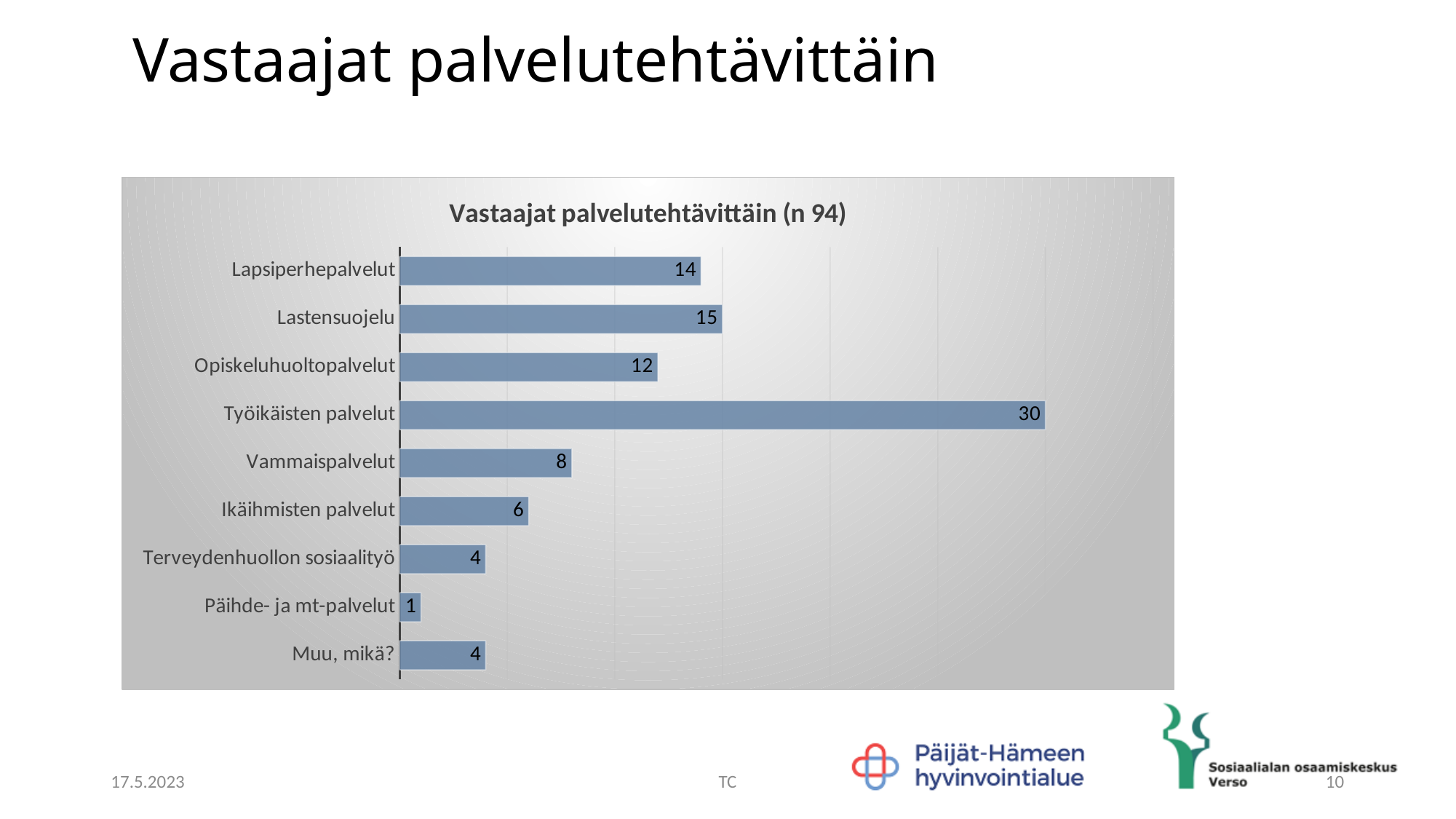
Which is larger, the value for Lapsiperhepalvelut or the value for Opiskeluhuoltopalvelut? Lapsiperhepalvelut What is the value for Päihde- ja mt-palvelut? 1 Which category has the highest value? Työikäisten palvelut Which category has the lowest value? Päihde- ja mt-palvelut What is the difference between the values for Vammaispalvelut and Ikäihmisten palvelut? 2 Which is larger, the value for Terveydenhuollon sosiaalityö or the value for Ikäihmisten palvelut? Ikäihmisten palvelut How many categories are shown in the chart? 9 What is the title of the chart? Vastaajat palvelutehtävittäin (n 94) What is the value for Lastensuojelu? 15 What kind of chart is shown on the slide? Bar chart What is the value for Työikäisten palvelut? 30 What is the difference between the values for Työikäisten palvelut and Lastensuojelu? 15